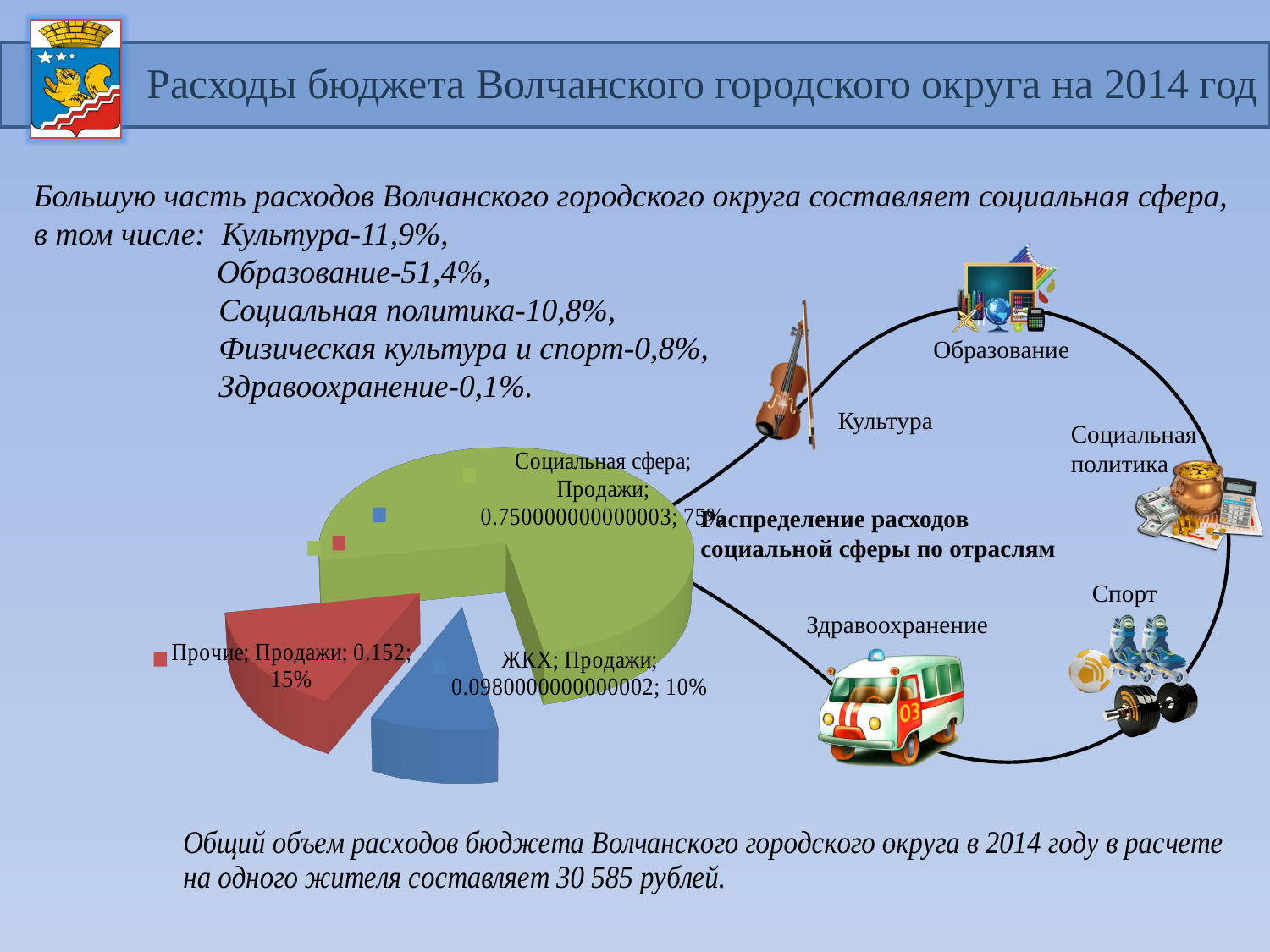
What kind of chart is shown on the slide? pie chart What colour is the ЖКХ slice in the pie chart? blue What colour is the Социальная сфера slice in the pie chart? green What value is printed on the data label for the Прочие slice? 0.152 Which slice is larger in the pie chart, Прочие or ЖКХ? Прочие What percentage of the pie chart does the Прочие slice represent? 15% How many slices does the pie chart have? 3 What is the difference in percentage points between the Социальная сфера slice and the Прочие slice? 60 What percentage of the pie chart does the ЖКХ slice represent? 10% What percentage of the pie chart does the Социальная сфера slice represent? 75% Which slice of the pie chart is the largest? Социальная сфера Which slice of the pie chart is the smallest? ЖКХ